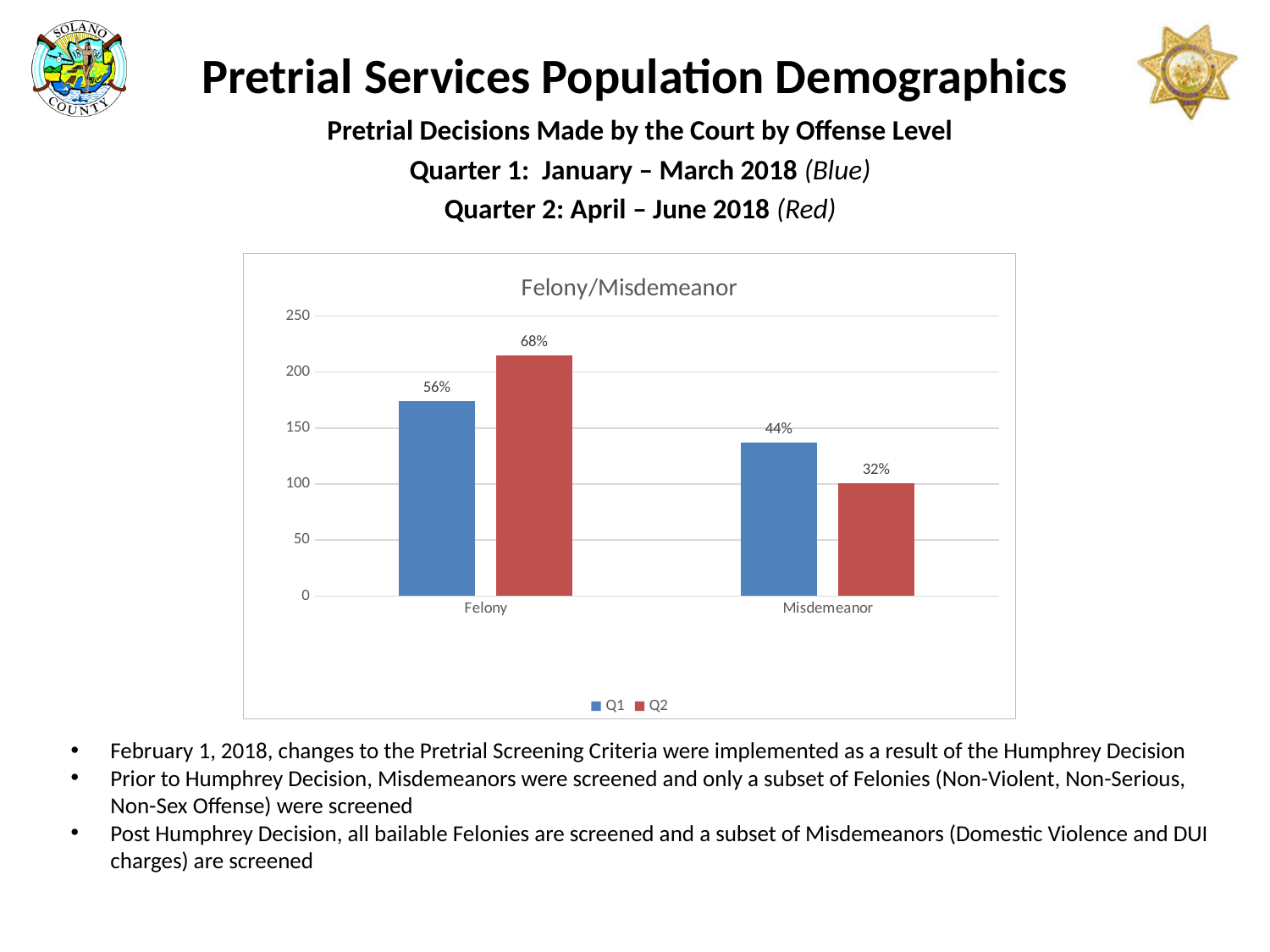
How many categories are shown on the x axis of the chart? 2 How many series does the chart legend list? 2 What is the title of the chart? Felony/Misdemeanor What type of chart is shown on the slide? bar chart What is the data label on the Q2 bar for Misdemeanor? 32% Which bar is the tallest in the chart? Q2 Felony What is the data label on the Q1 bar for Misdemeanor? 44% What is the data label on the Q2 bar for Felony? 68% What is the data label on the Q1 bar for Felony? 56% Which bar is the shortest in the chart? Q2 Misdemeanor Is the Q2 bar for Felony greater or less than 200 on the y axis? greater Which is larger for Misdemeanor, the Q1 bar or the Q2 bar? Q1